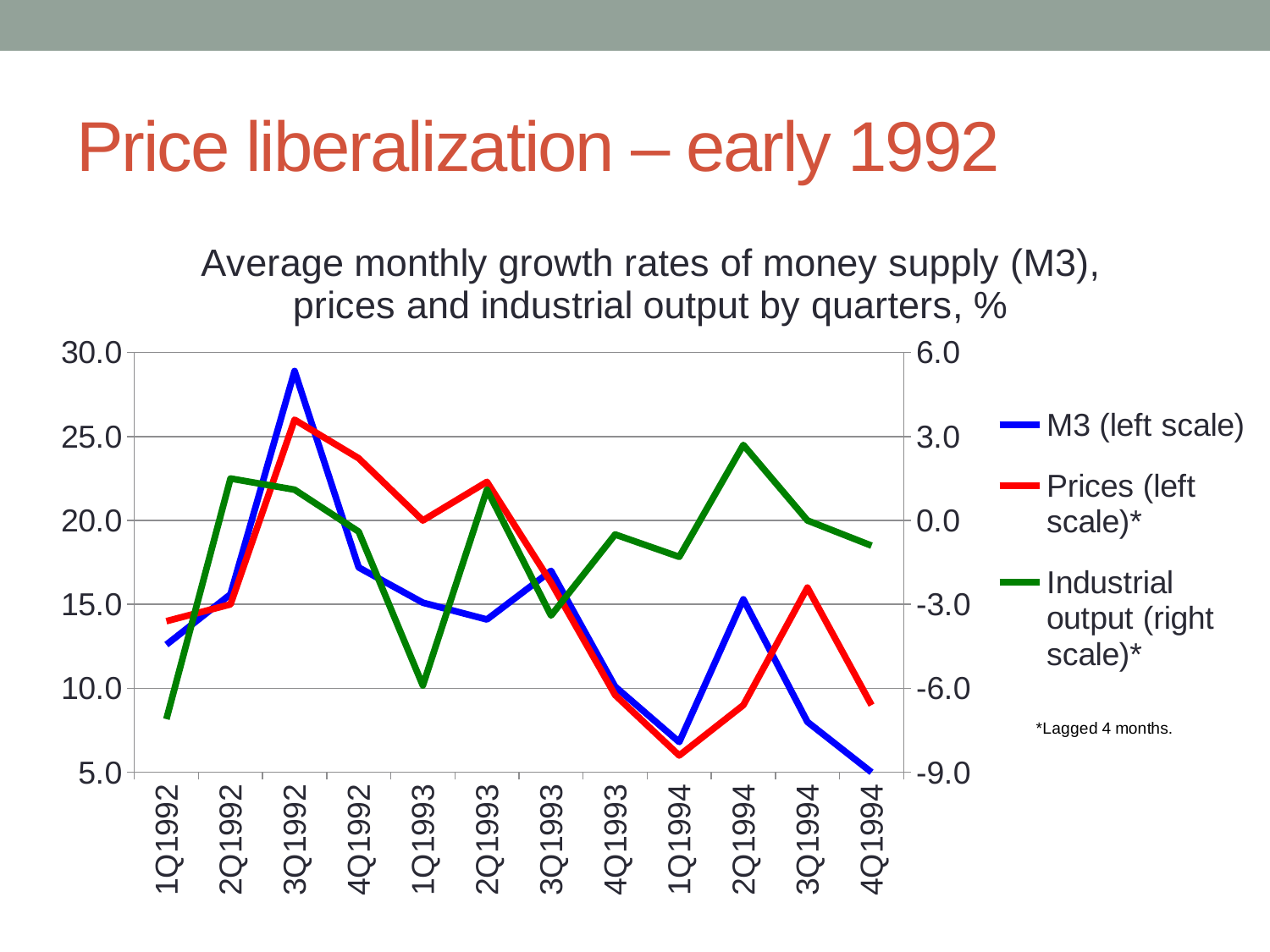
Is the value for M3 in 3Q1992 greater or less than 25.0? greater What does the footnote below the legend say? *Lagged 4 months. Is the value for Industrial output in 1Q1993 greater or less than -3.0? less In which quarter does M3 reach its highest value? 3Q1992 How many quarters are plotted along the x axis? 12 How many series does the legend list? 3 What kind of chart is shown on the slide? line chart Is the value for Prices in 1Q1994 greater or less than 10.0? less In which quarter does Industrial output reach its highest value? 2Q1994 In which quarter does Industrial output reach its lowest value? 1Q1992 In 3Q1994, which is higher: M3 or Prices? Prices In which quarter is the Prices series at its lowest? 1Q1994